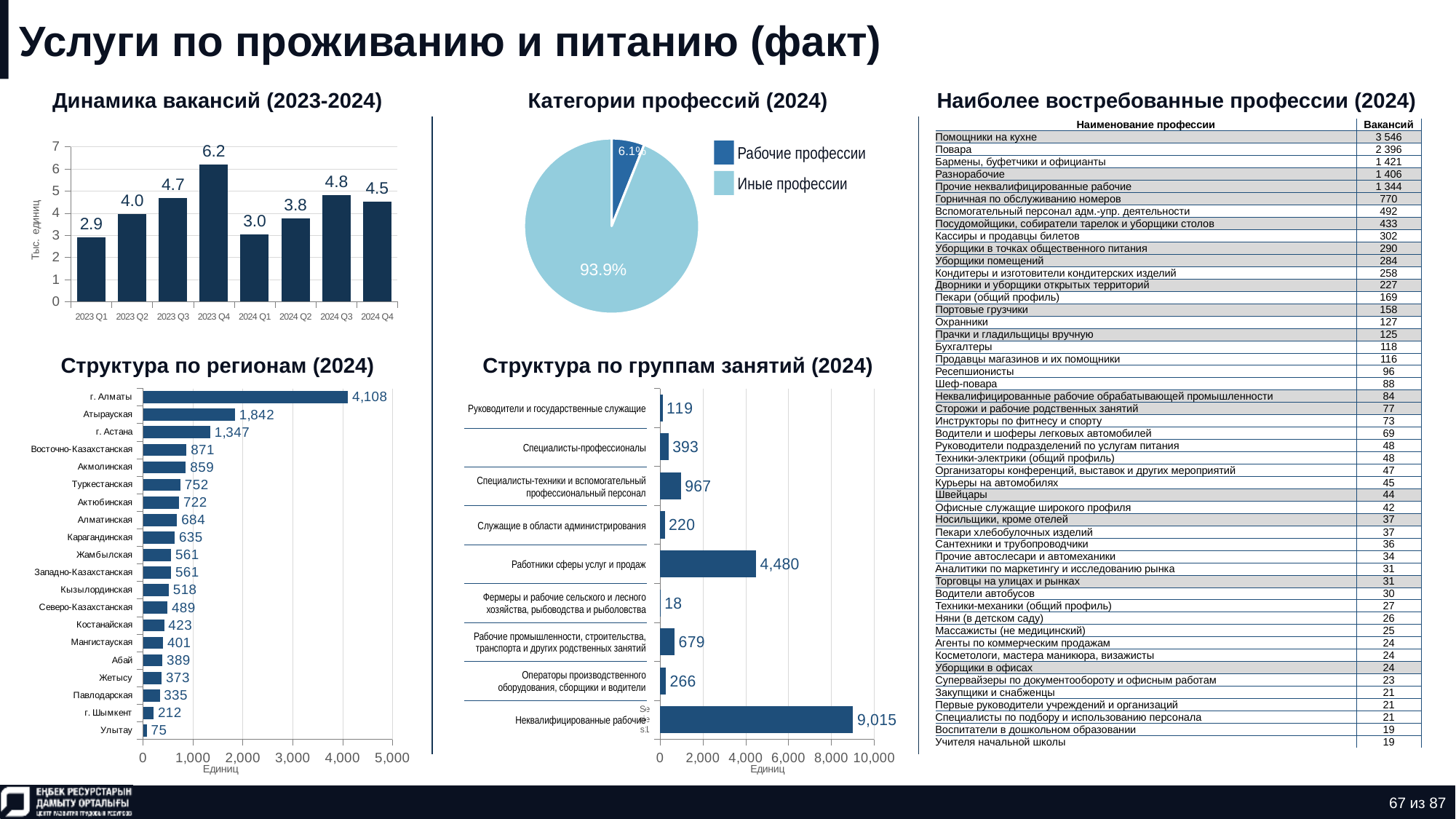
In the chart 'Структура по группам занятий (2024)', what is the value for 'Работники сферы услуг и продаж'? 4,480 In the chart 'Структура по группам занятий (2024)', which group has the lowest value? Фермеры и рабочие сельского и лесного хозяйства, рыбоводства и рыболовства In the chart 'Динамика вакансий (2023-2024)', what is the difference between 2024 Q3 and 2024 Q1? 1.8 In the chart 'Структура по регионам (2024)', which region has the highest value? г. Алматы In the chart 'Динамика вакансий (2023-2024)', which quarter has the lowest value? 2023 Q1 In the chart 'Динамика вакансий (2023-2024)', what is the value for 2023 Q4? 6.2 In the chart 'Динамика вакансий (2023-2024)', how many quarters are plotted? 8 In the chart 'Структура по регионам (2024)', which is larger: Акмолинская or Туркестанская? Акмолинская In the chart 'Структура по регионам (2024)', what is the value for Атырауская? 1,842 What kind of chart is 'Структура по регионам (2024)'? bar chart What kind of chart is 'Категории профессий (2024)'? pie chart In the chart 'Категории профессий (2024)', what share of the pie is 'Рабочие профессии'? 6.1%